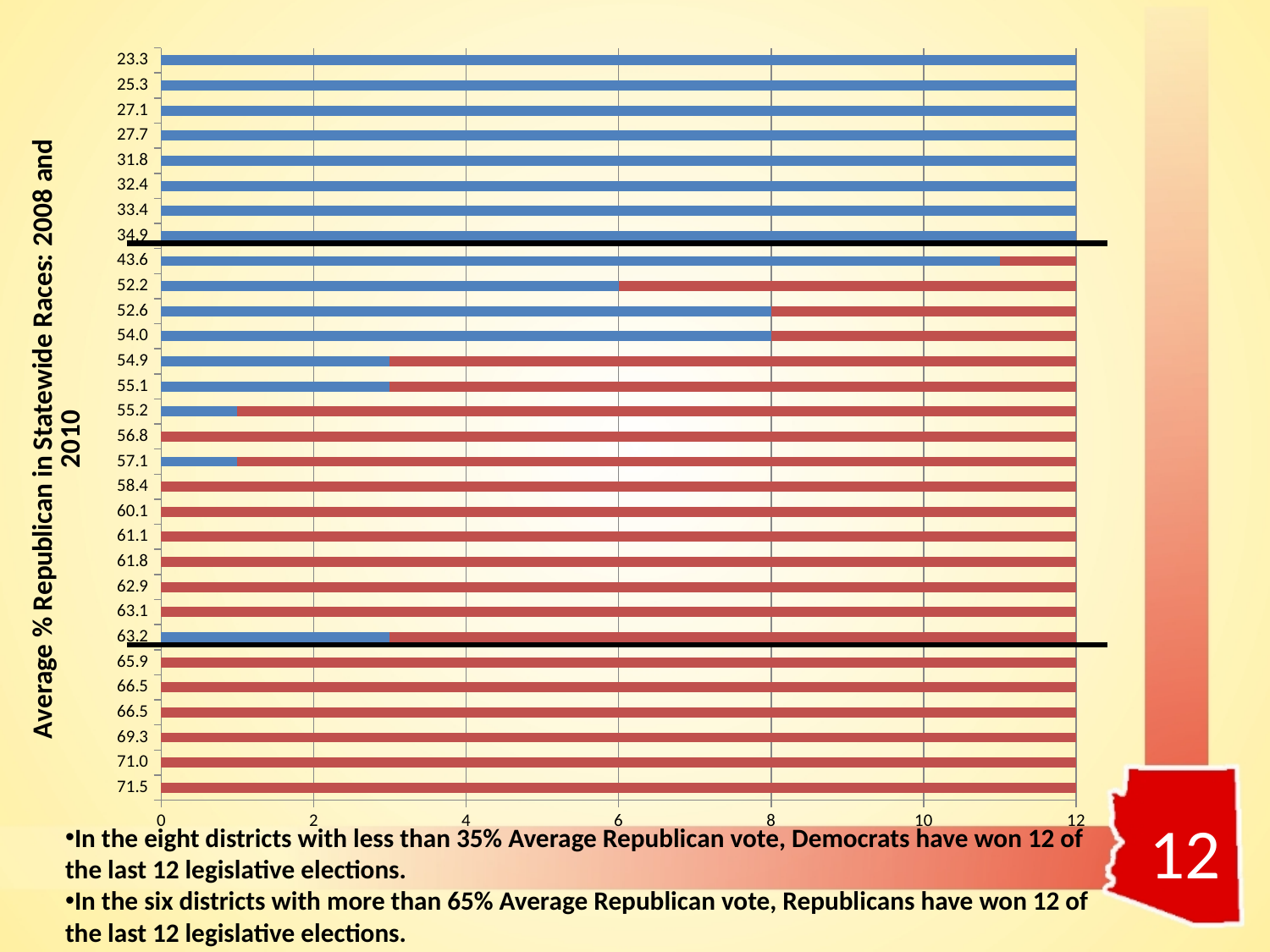
What is the value of the blue segment for the 54.0 category? 8 Is the blue segment for the 43.6 category greater or less than 10? greater Is the blue segment for the 54.9 category greater or less than 4? less What is the value of the blue segment for the 52.6 category? 8 What kind of chart is shown on the slide? bar chart What is the value of the red segment for the 52.2 category? 6 How many categories (districts) are plotted on the chart? 30 What is the highest value shown on the horizontal axis? 12 Which has the larger blue segment, the 52.2 category or the 52.6 category? 52.6 What is the title of the vertical axis of the chart? Average % Republican in Statewide Races: 2008 and 2010 What is the value of the blue segment for the 52.2 category? 6 What is the total length of the bar for the 23.3 category? 12